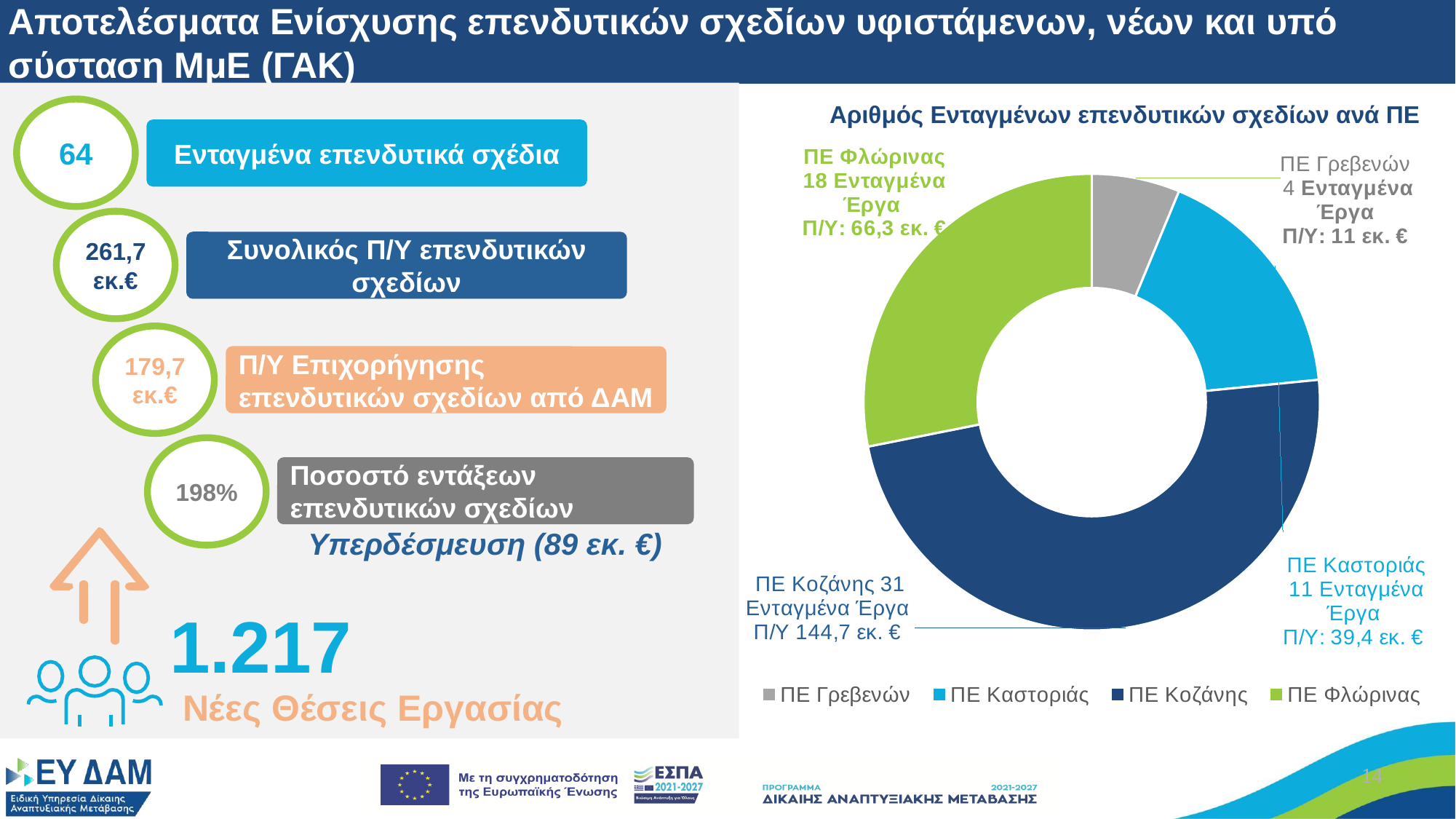
How many more ενταγμένα έργα does ΠΕ Φλώρινας have than ΠΕ Καστοριάς? 7 Which ΠΕ has the highest number of ενταγμένα έργα in the chart? ΠΕ Κοζάνης What is the title of the chart on the slide? Αριθμός Ενταγμένων επενδυτικών σχεδίων ανά ΠΕ Which ΠΕ has the lowest number of ενταγμένα έργα in the chart? ΠΕ Γρεβενών What is the Π/Υ shown for ΠΕ Φλώρινας in the chart? 66,3 εκ. € How many ΠΕ (regional units) are shown in the chart? 4 What type of chart is shown on the slide? Doughnut (pie) chart How many ενταγμένα έργα does ΠΕ Γρεβενών have according to the chart? 4 Which has more ενταγμένα έργα, ΠΕ Καστοριάς or ΠΕ Γρεβενών? ΠΕ Καστοριάς How many entries does the chart legend list? 4 What is the Π/Υ shown for ΠΕ Καστοριάς in the chart? 39,4 εκ. € How many ενταγμένα έργα does ΠΕ Κοζάνης have according to the chart? 31